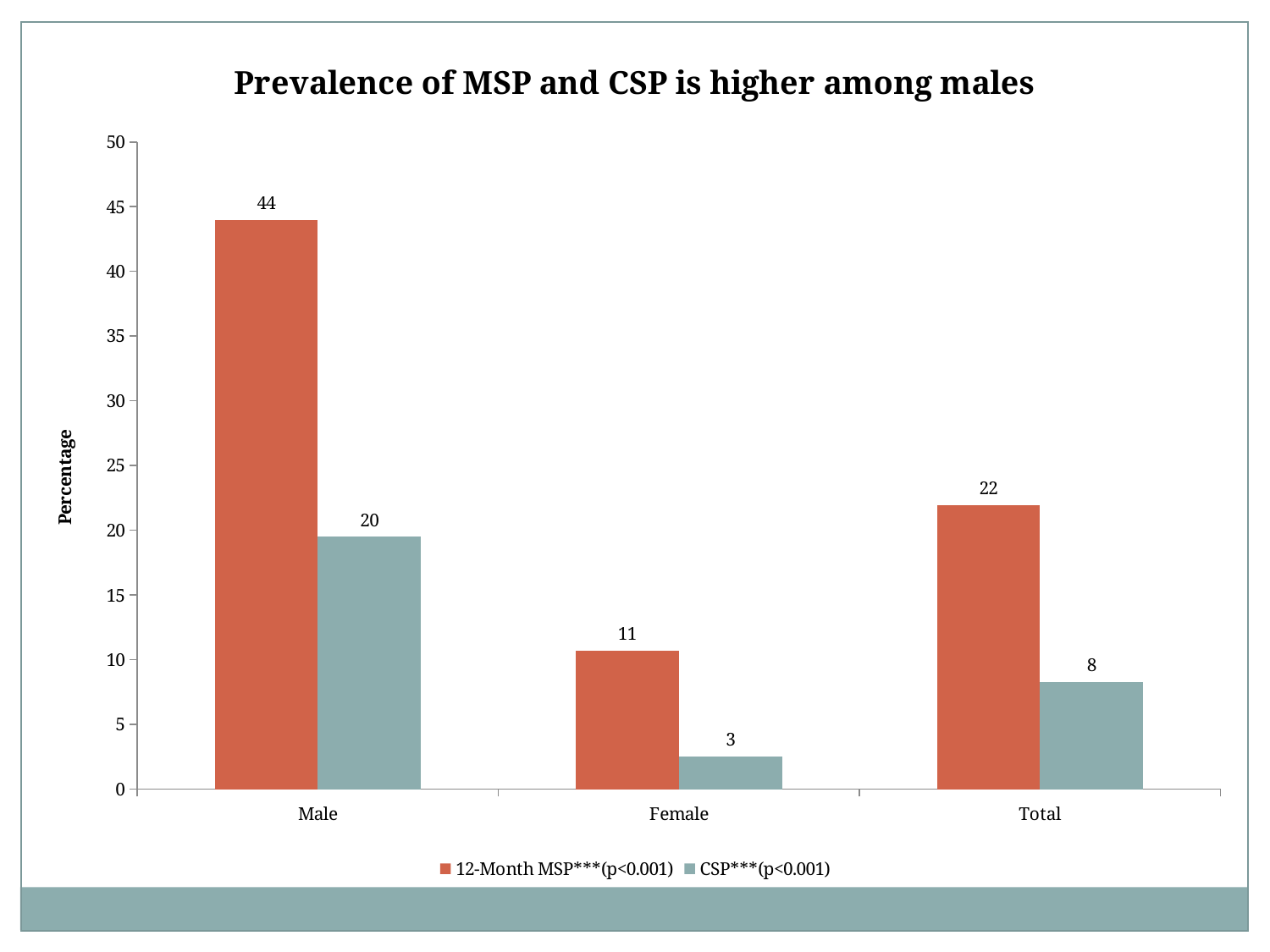
What kind of chart is shown on the slide? bar chart What is the CSP value for Male? 20 Which category has the lowest CSP value? Female How many series does the legend list? 2 Is the 12-Month MSP value for Female greater or less than 15? less What is the 12-Month MSP value for Total? 22 What is the CSP value for Female? 3 How many categories are shown on the x axis? 3 What is the 12-Month MSP value for Male? 44 Which is larger, the CSP value for Total or the CSP value for Female? Total Which category has the highest 12-Month MSP value? Male What is the difference between the 12-Month MSP values for Male and Female? 33